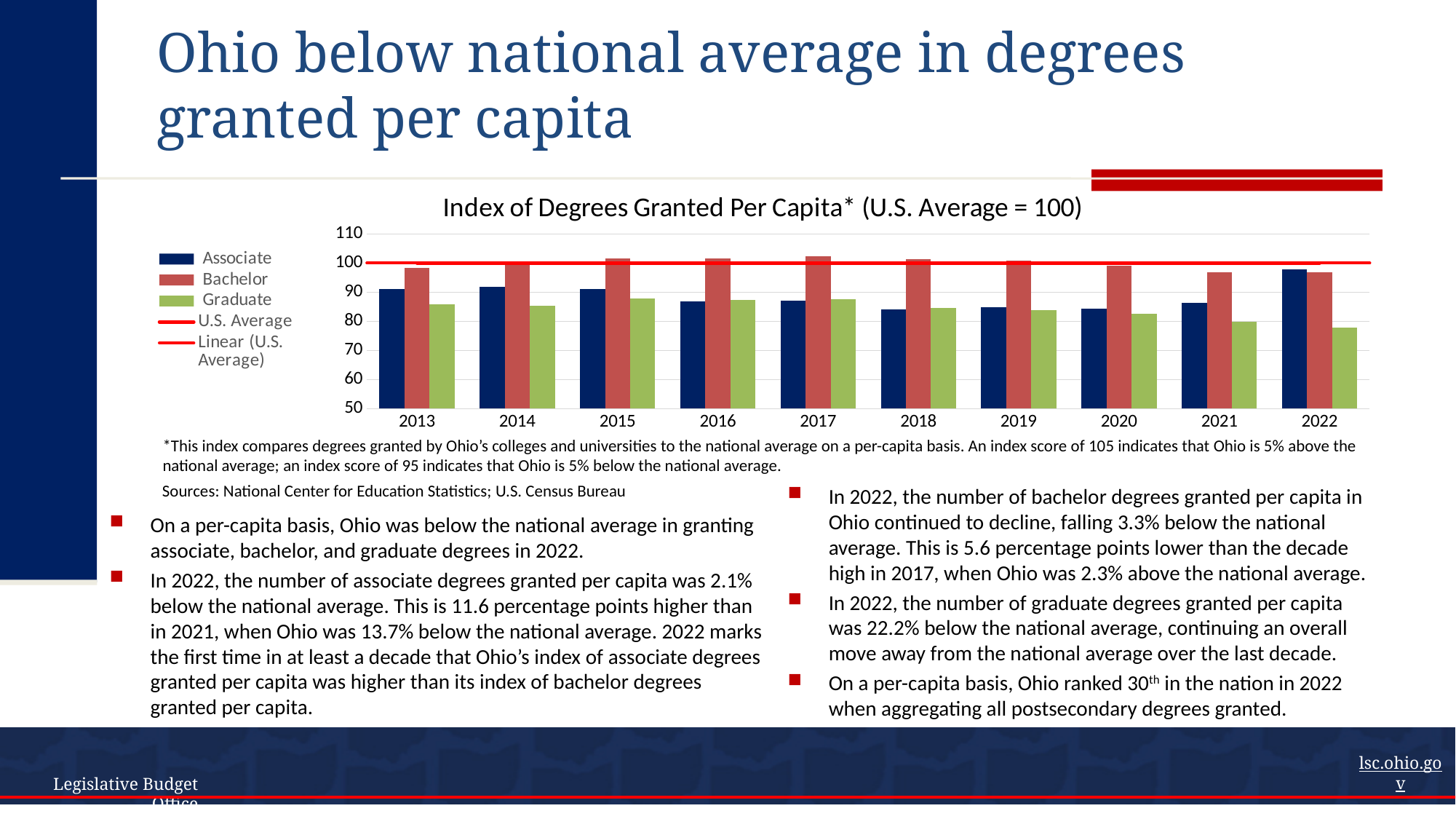
What value does the red U.S. Average line represent? 100 In which year is the Associate bar the highest? 2022 Is the Bachelor value for 2021 greater or less than 100? less Is the Graduate value for 2022 greater or less than 80? less How many entries does the chart's legend list? 5 What is the title of the chart? Index of Degrees Granted Per Capita* (U.S. Average = 100) Do the Graduate values generally rise or fall from 2013 to 2022? fall How many years are shown on the x axis of the chart? 10 What kind of chart is shown on the slide? Bar chart Which degree series has the lowest bar in 2022? Graduate In 2021, which is larger, the Associate value or the Bachelor value? Bachelor In which year is the Graduate bar the lowest? 2022